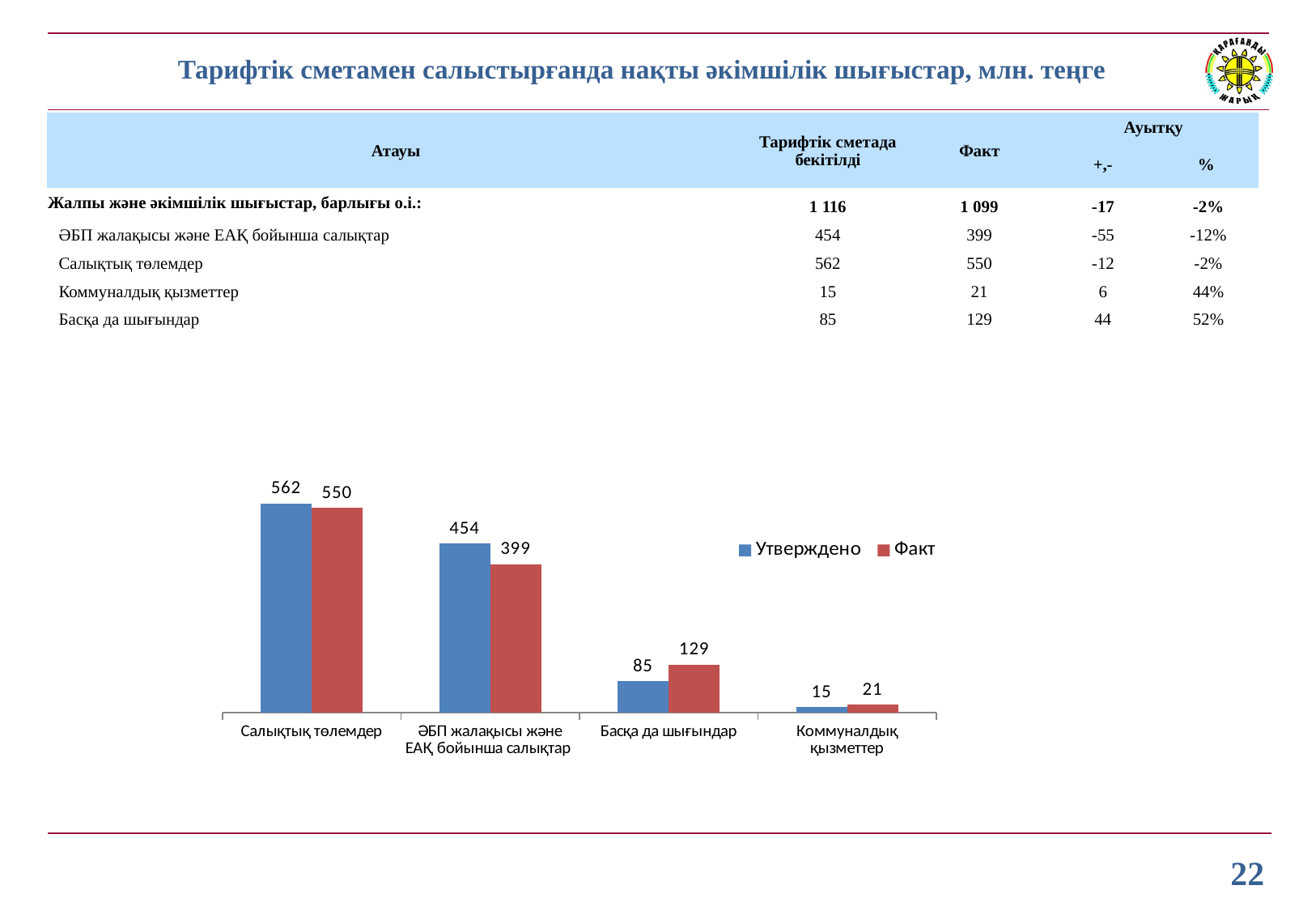
Which is larger for Коммуналдық қызметтер, the Утверждено value or the Факт value? Факт Which category has the highest Факт value? Салықтық төлемдер What is the Утверждено value for Коммуналдық қызметтер? 15 What is the Факт value for Басқа да шығындар? 129 What is the difference between the Факт and Утверждено values for Басқа да шығындар? 44 How many series does the chart legend list? 2 What is the difference between the Утверждено and Факт values for ӘБП жалақысы және ЕАҚ бойынша салықтар? 55 What is the Утверждено value for Салықтық төлемдер? 562 What kind of chart is shown on the slide? Bar chart What is the Факт value for ӘБП жалақысы және ЕАҚ бойынша салықтар? 399 Which category has the lowest Утверждено value? Коммуналдық қызметтер How many categories are shown on the x axis of the chart? 4